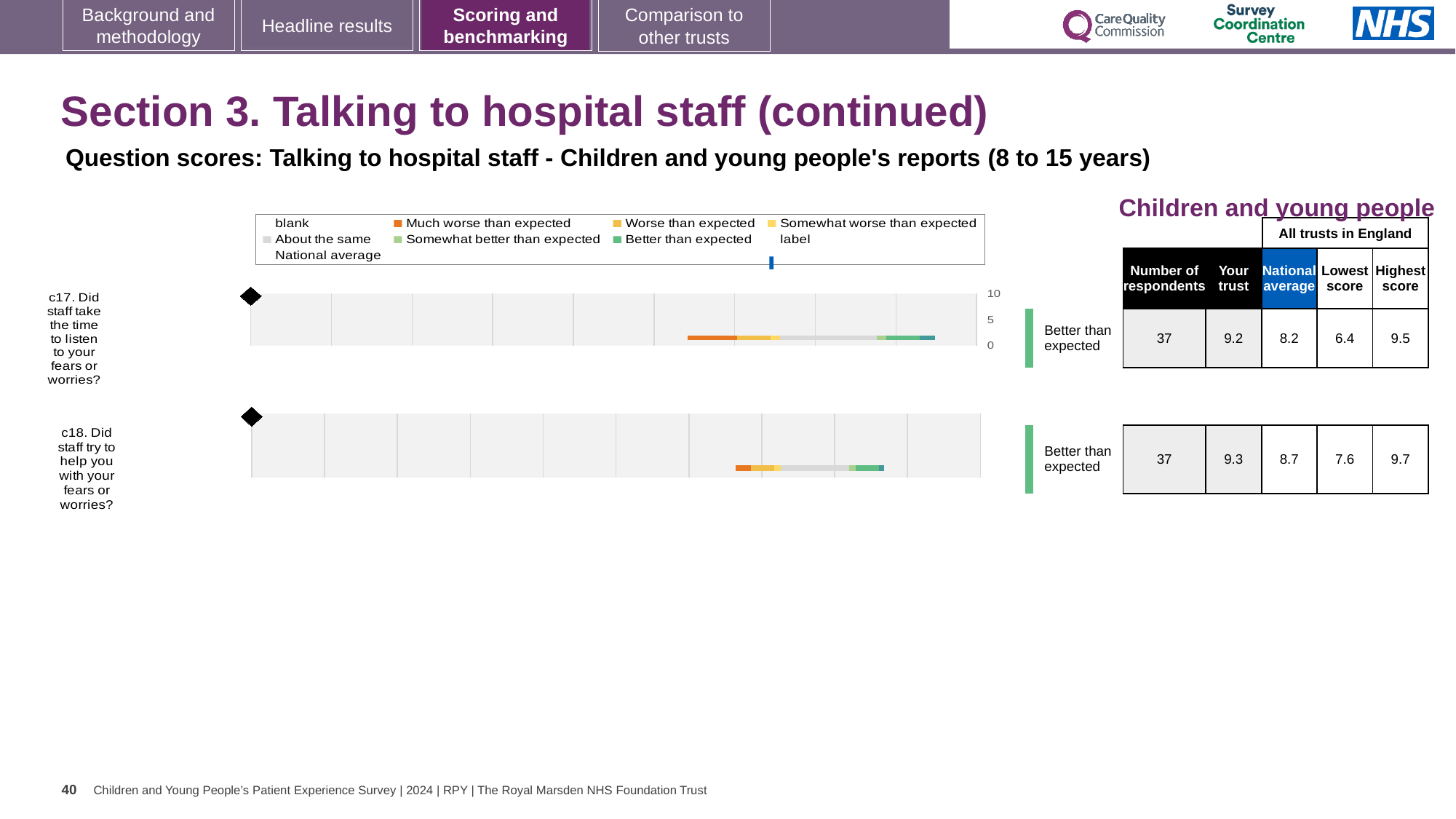
How many survey questions are plotted on this slide? 2 For question c17, which is higher: the trust's score or the national average? Your trust (9.2) What is the 'Your trust' score for question c17 (Did staff take the time to listen to your fears or worries?)? 9.2 How many respondents answered question c17? 37 What is the difference between the highest score and the lowest score for question c18? 2.1 What benchmarking category is the trust's result for question c18 labelled as? Better than expected What is the national average score for question c18 (Did staff try to help you with your fears or worries?)? 8.7 What type of chart is used to show the benchmarking results for each question? Bar chart What is the lowest score among all trusts in England for question c18? 7.6 By how much does the trust's score for c17 exceed the national average? 1.0 Which of the two questions shown has the higher 'Your trust' score? c18 (9.3) What is the highest score among all trusts in England for question c17? 9.5